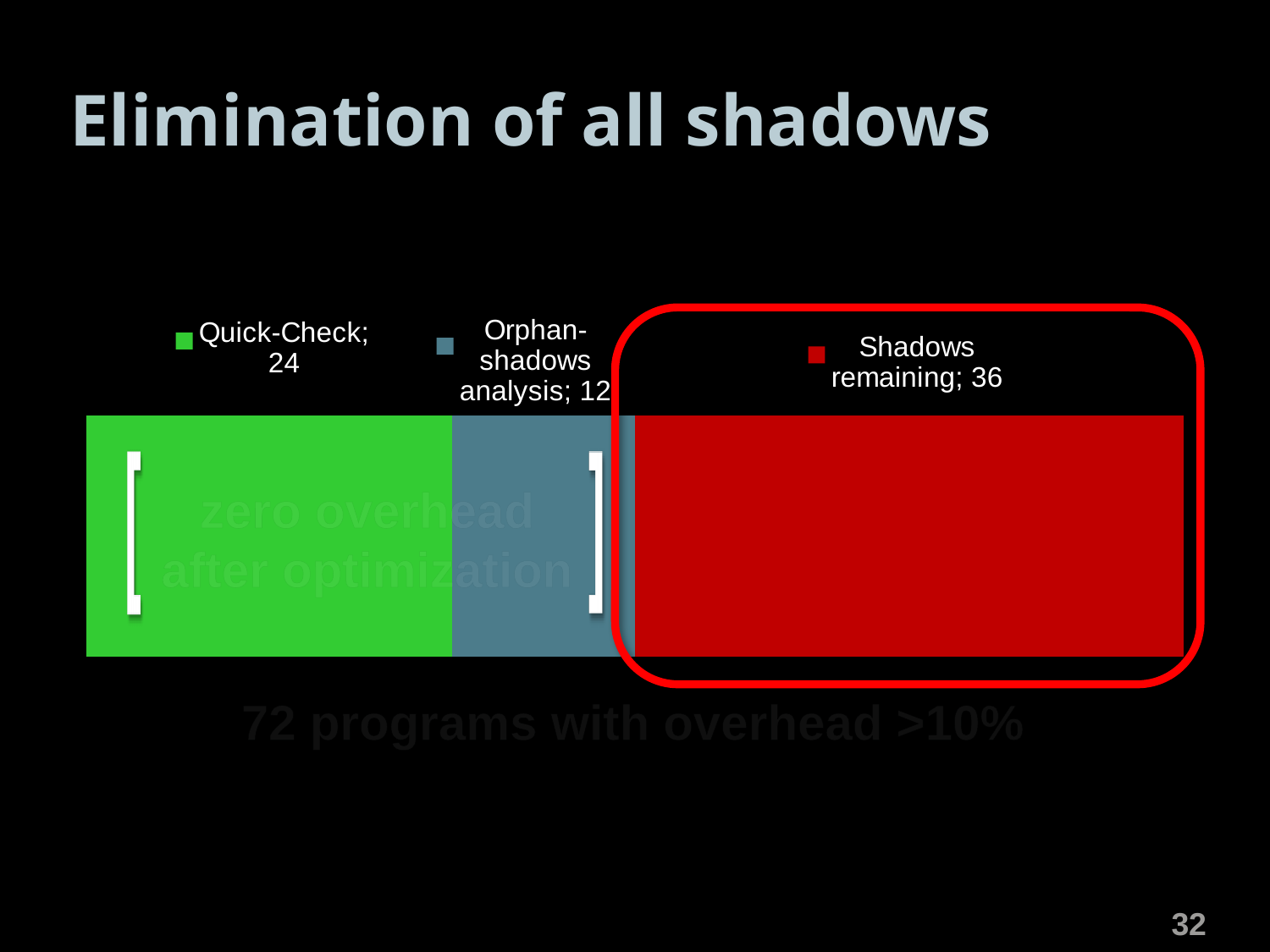
What colour is the Shadows remaining segment? Red What is the difference between the Quick-Check value and the Orphan-shadows analysis value? 12 What value is shown for Quick-Check in the legend? 24 What value is shown for Orphan-shadows analysis? 12 Which segment of the bar has the largest value? Shadows remaining What kind of chart is shown on the slide? Stacked bar chart What value is shown for Shadows remaining? 36 What is the total of all segments in the stacked bar? 72 How many series does the legend list? 3 Which segment of the bar has the smallest value? Orphan-shadows analysis What is the difference between the Shadows remaining value and the Quick-Check value? 12 Which is larger, the value for Quick-Check or the value for Orphan-shadows analysis? Quick-Check